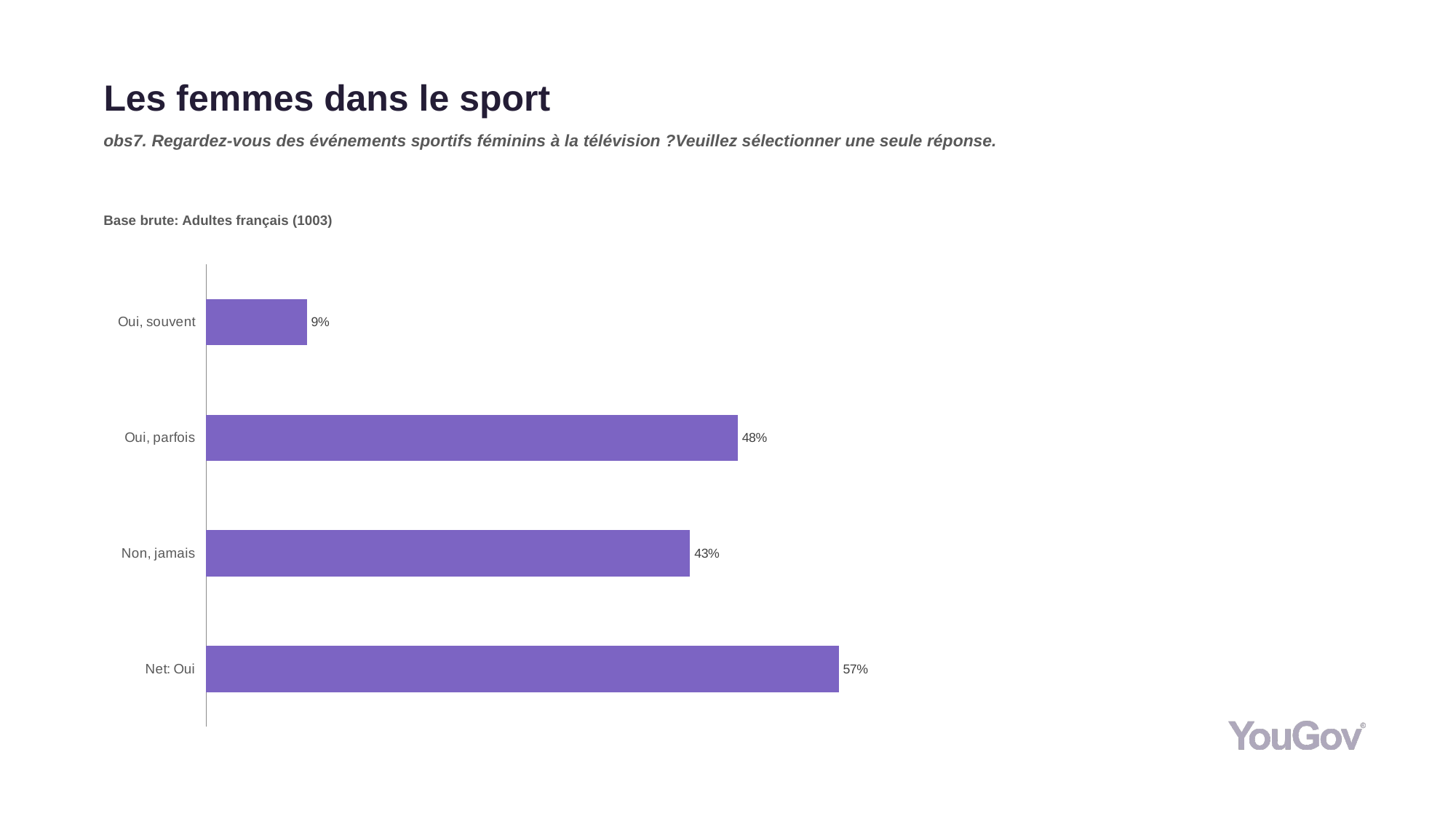
Which is larger, "Oui, parfois" or "Non, jamais"? Oui, parfois What is the value for "Net: Oui"? 57% What is the base (sample) stated above the chart? Adultes français (1003) What is the value for "Oui, parfois"? 48% What kind of chart is shown on the slide? Bar chart Which category has the highest value? Net: Oui What is the difference between "Net: Oui" and "Oui, souvent"? 48% Which category has the lowest value? Oui, souvent What is the difference between "Oui, parfois" and "Non, jamais"? 5% How many categories are shown in the chart? 4 What is the value for "Non, jamais"? 43% What is the value for "Oui, souvent"? 9%